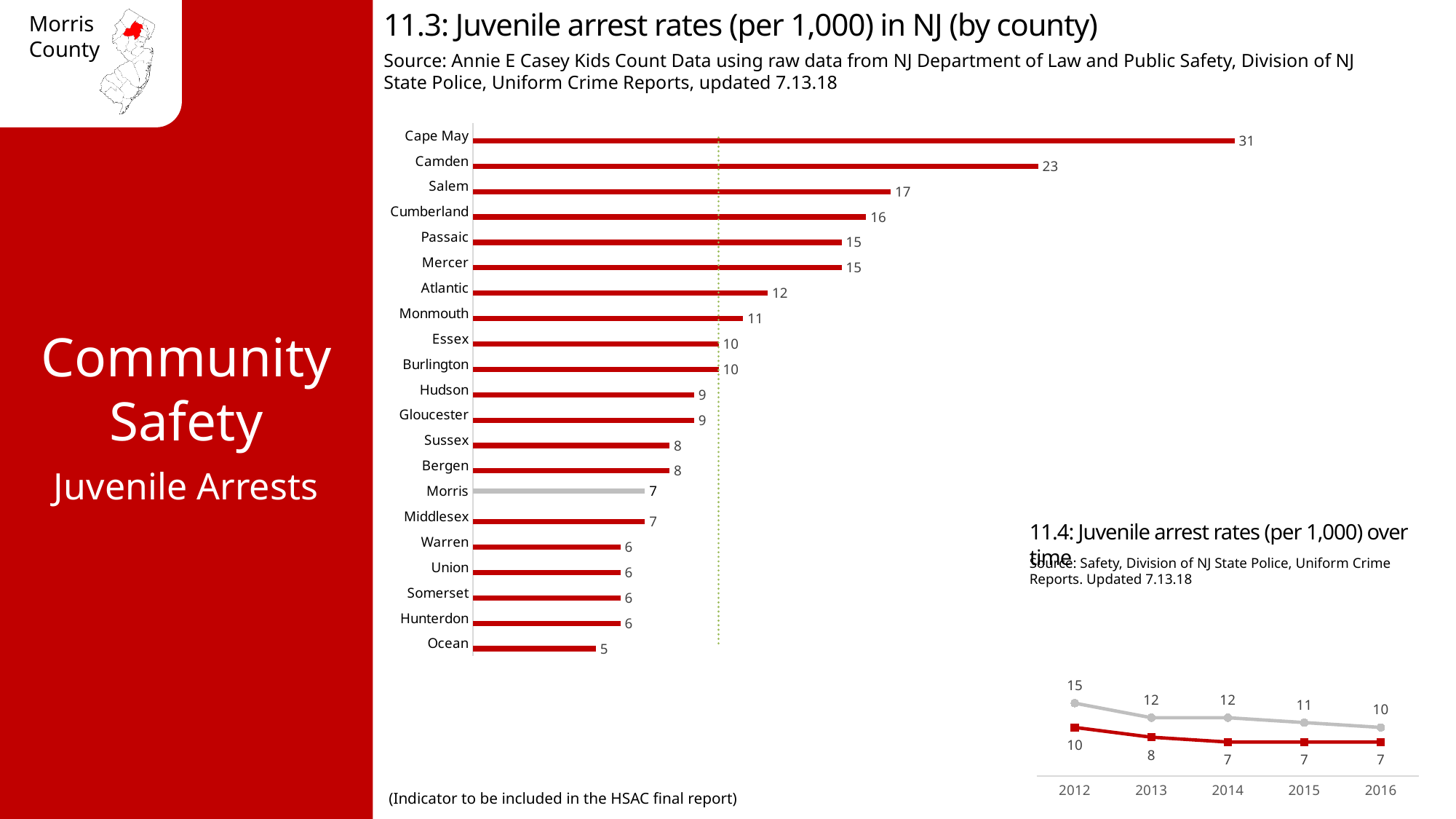
In chart 11.4 (juvenile arrest rates over time), does the gray line rise or fall from 2012 to 2016? Fall In chart 11.4 (juvenile arrest rates over time), what is the value of the gray line in 2012? 15 In chart 11.3 (juvenile arrest rates by county), how many counties are shown? 21 In chart 11.3 (juvenile arrest rates by county), which county has the lowest juvenile arrest rate? Ocean What kind of chart is chart 11.3 (juvenile arrest rates by county)? Bar chart In chart 11.3 (juvenile arrest rates by county), which county has the highest juvenile arrest rate? Cape May In chart 11.3 (juvenile arrest rates by county), what is the value for Morris? 7 In chart 11.4 (juvenile arrest rates over time), what is the value of the red line in 2016? 7 In chart 11.3 (juvenile arrest rates by county), what is the value for Camden? 23 In chart 11.3 (juvenile arrest rates by county), which county's bar is shown in gray instead of red? Morris In chart 11.3 (juvenile arrest rates by county), what is the difference between the values for Cape May and Camden? 8 In chart 11.3 (juvenile arrest rates by county), which has a higher value, Salem or Atlantic? Salem